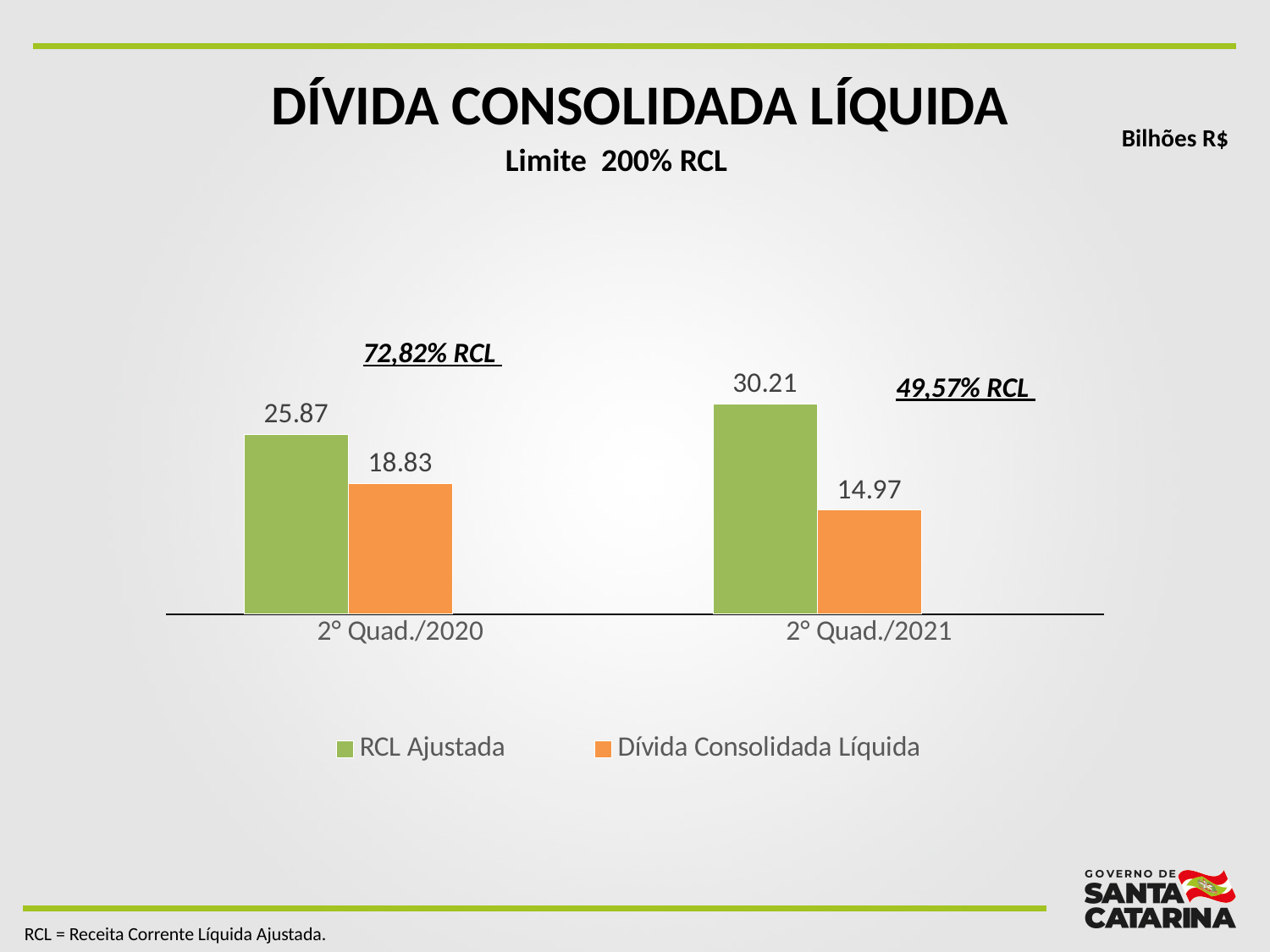
What is the difference in RCL Ajustada between 2° Quad./2021 and 2° Quad./2020? 4.34 How many periods are shown on the x axis? 2 How many series does the legend list? 2 What is the difference between RCL Ajustada and Dívida Consolidada Líquida in 2° Quad./2021? 15.24 Which period has the highest RCL Ajustada value? 2° Quad./2021 Which period has the lowest Dívida Consolidada Líquida value? 2° Quad./2021 Which is larger: Dívida Consolidada Líquida in 2° Quad./2020 or in 2° Quad./2021? 2° Quad./2020 What kind of chart is shown on the slide? Bar chart What is the value of RCL Ajustada for 2° Quad./2020? 25.87 What is the value of Dívida Consolidada Líquida for 2° Quad./2020? 18.83 What is the value of RCL Ajustada for 2° Quad./2021? 30.21 What is the value of Dívida Consolidada Líquida for 2° Quad./2021? 14.97